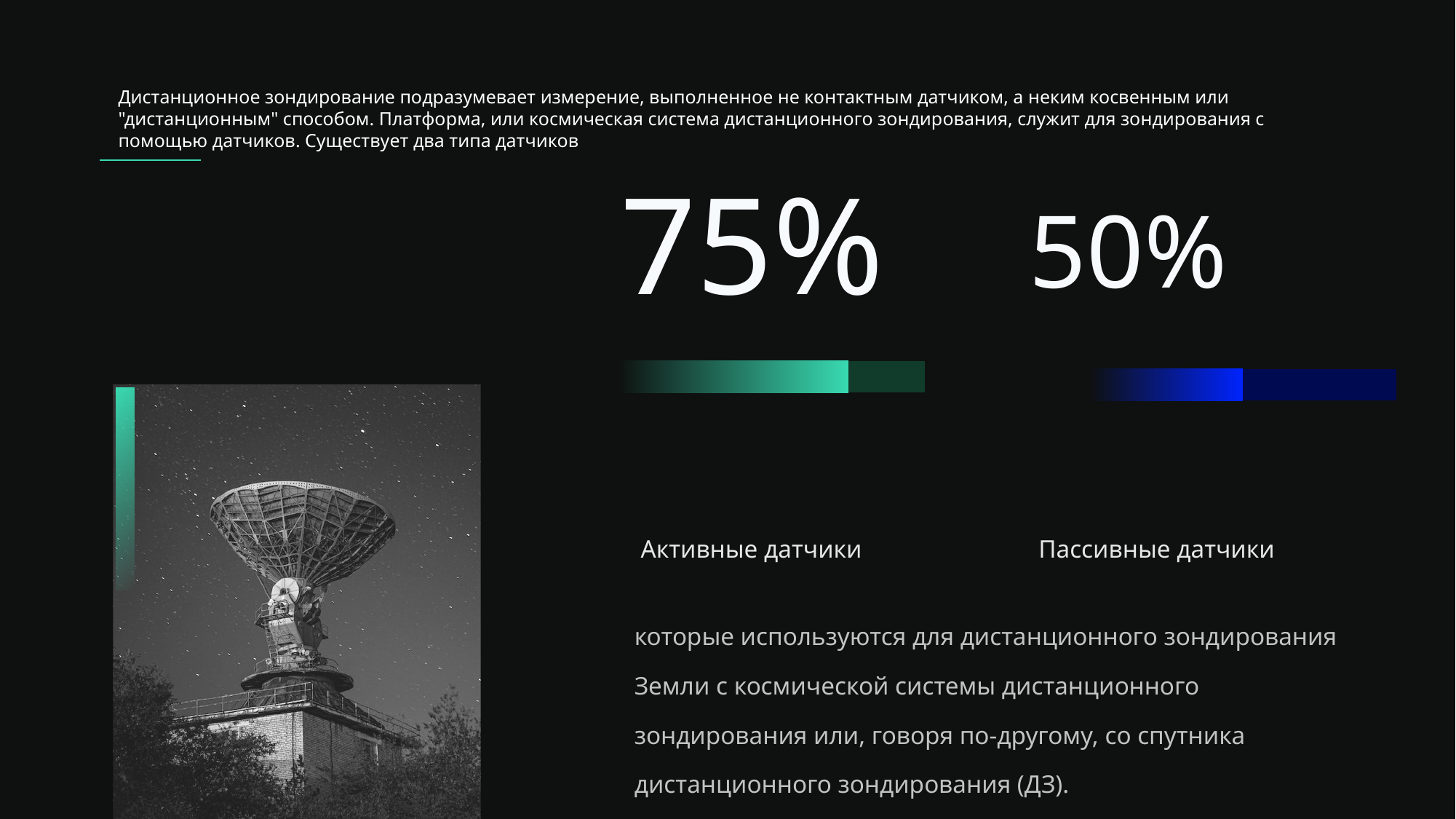
What colour is the bar for Пассивные датчики? blue What is the difference between the percentages for Активные датчики and Пассивные датчики? 25% Which category has the highest percentage? Активные датчики What percentage is shown for Активные датчики? 75% Which category has the higher percentage, Активные датчики or Пассивные датчики? Активные датчики How many categories are shown with percentage bars on the slide? 2 Which category has the lowest percentage? Пассивные датчики What kind of chart is used to show the percentages on the slide? bar chart What percentage is shown for Пассивные датчики? 50% What colour is the bar for Активные датчики? green